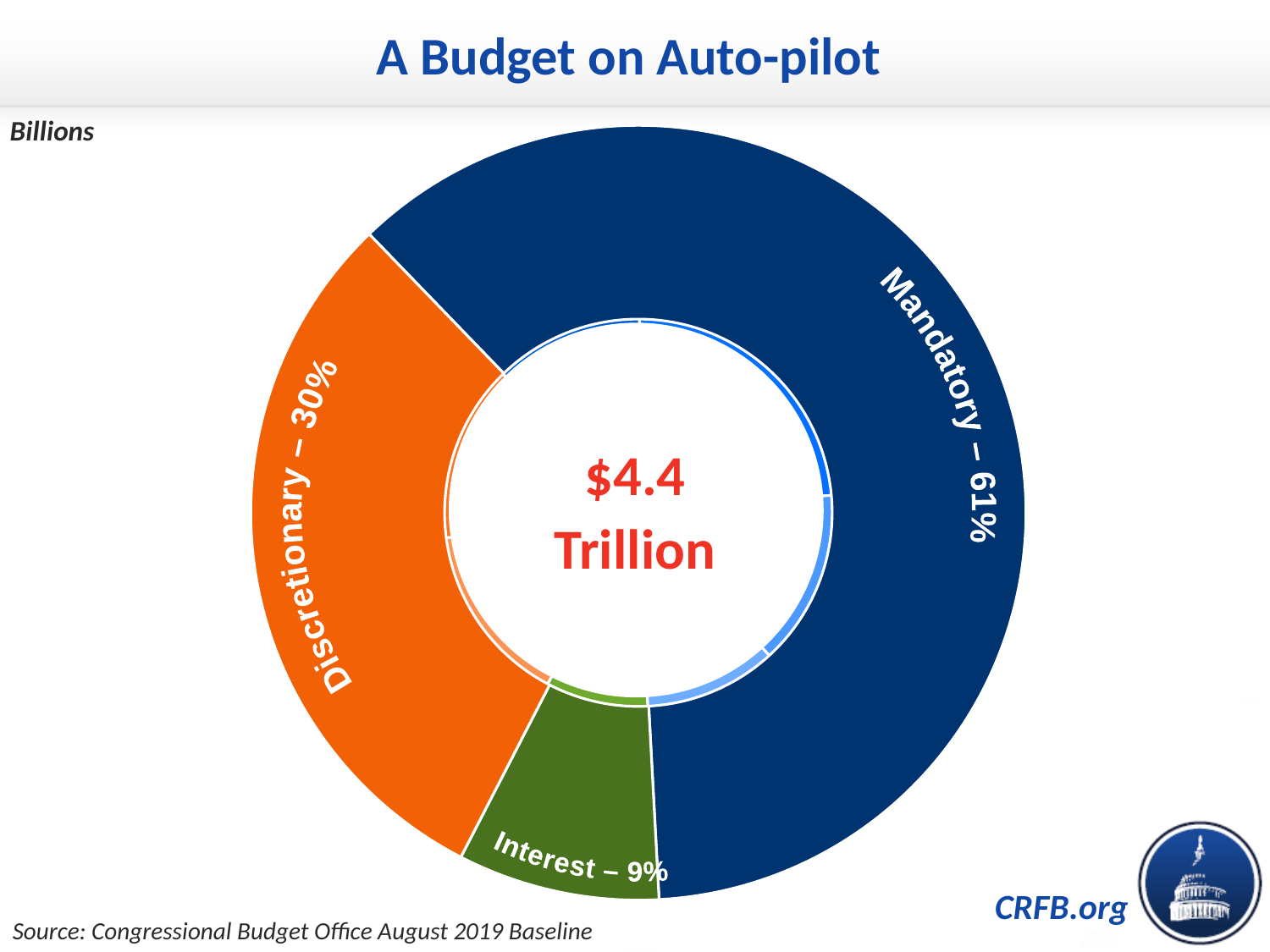
Which is larger, the Discretionary share or the Interest share? Discretionary Which category has the largest share of the budget? Mandatory What kind of chart is shown on the slide? Pie chart (doughnut) What share of the budget is Discretionary spending? 30% What total amount is shown in the centre of the chart? $4.4 Trillion How many categories does the chart show? 3 What colour is the Interest slice? Green Which category has the smallest share of the budget? Interest What is the title of the slide? A Budget on Auto-pilot What share of the budget is Interest? 9% What share of the budget is Mandatory spending? 61% What is the difference in percentage points between the Mandatory and Discretionary shares? 31